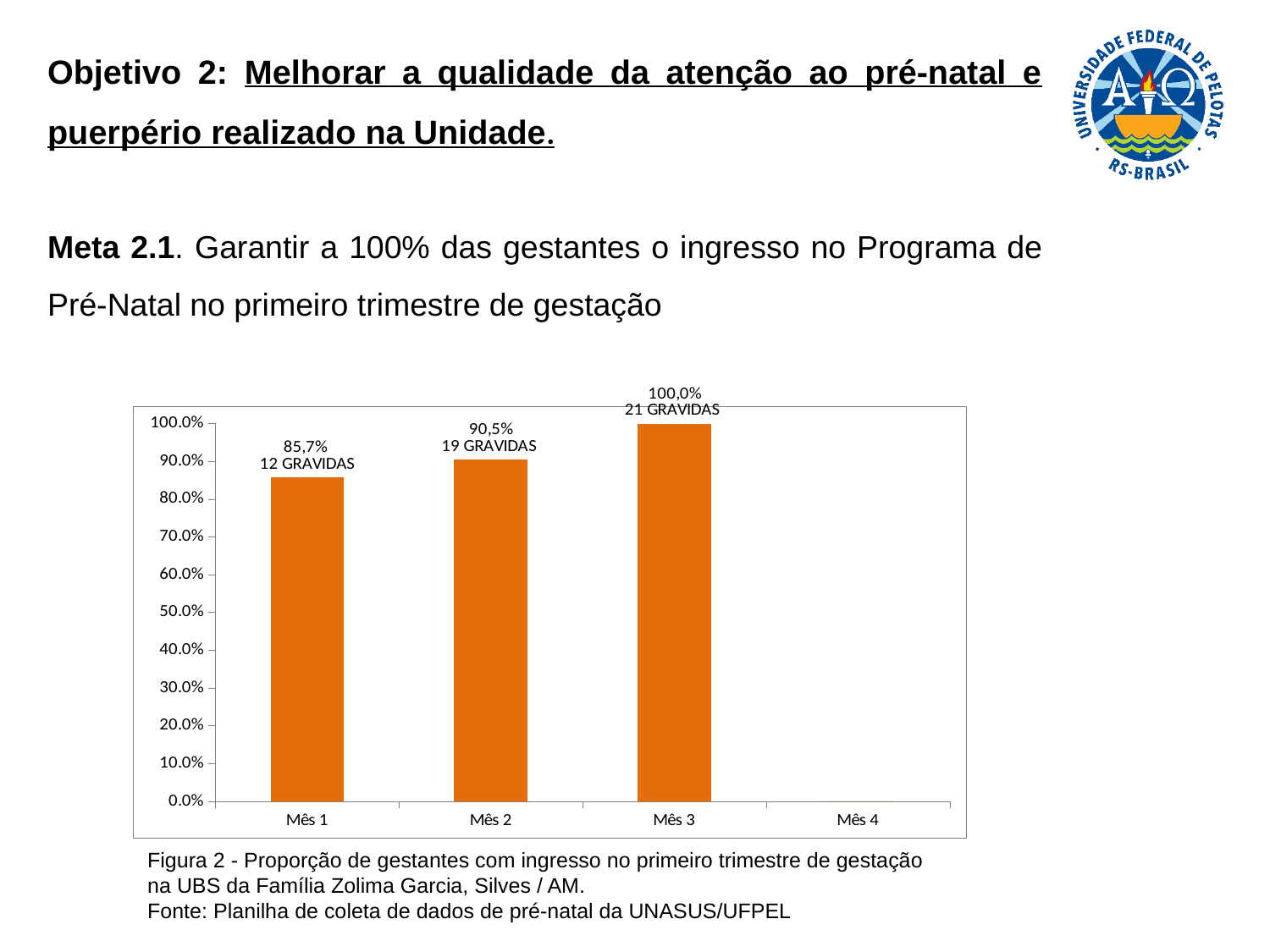
Which month has the highest percentage in the chart? Mês 3 What is the difference in percentage points between Mês 3 and Mês 1? 14,3 What is the percentage value shown for Mês 1? 85,7% Which is larger, the value for Mês 1 or the value for Mês 2? Mês 2 How many month categories are shown on the x axis? 4 What is the percentage value shown for Mês 3? 100,0% What kind of chart is shown on the slide? bar chart How many gravidas are indicated in the data label for Mês 2? 19 GRAVIDAS How many more gravidas are shown for Mês 3 than for Mês 1? 9 Is the value for Mês 1 greater or less than 80.0%? greater What is the percentage value shown for Mês 2? 90,5% Do the values rise or fall from Mês 1 to Mês 3? rise